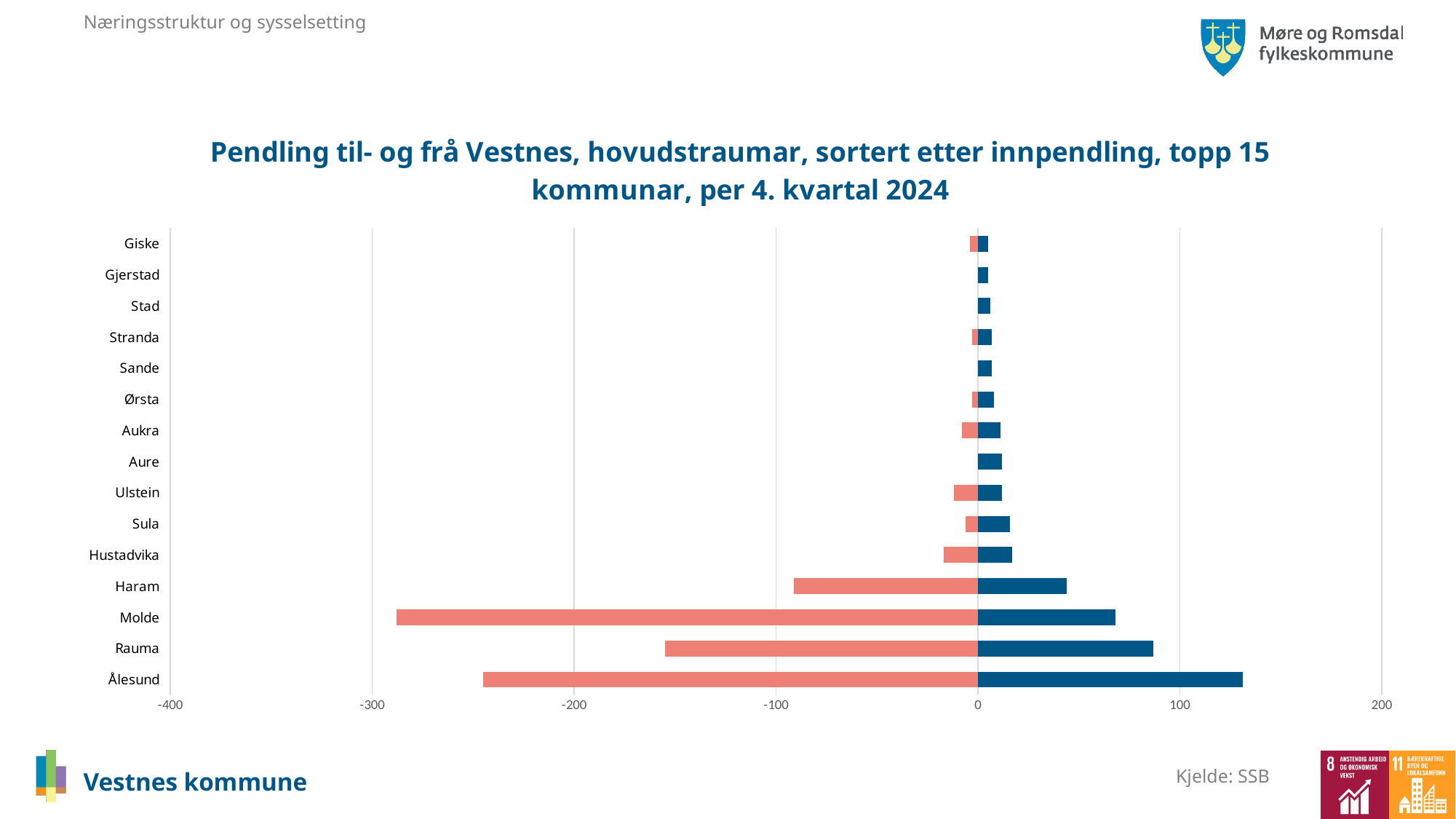
How many municipalities are listed on the vertical axis of the chart? 15 Which has the longer red bar, Molde or Rauma? Molde Is the blue bar value for Ålesund greater or less than 100? greater Is the red bar value for Molde greater or less than -200? less Do the blue bars get longer or shorter moving down the chart from Giske to Ålesund? longer Which municipality has the longest red bar extending furthest to the left in the chart? Molde Which municipality has the longest blue bar (highest innpendling) in the chart? Ålesund Which has the longer blue bar, Rauma or Molde? Rauma Is the blue bar value for Rauma greater or less than 100? less What kind of chart is shown on the slide? bar chart What is the source cited for the chart data? SSB